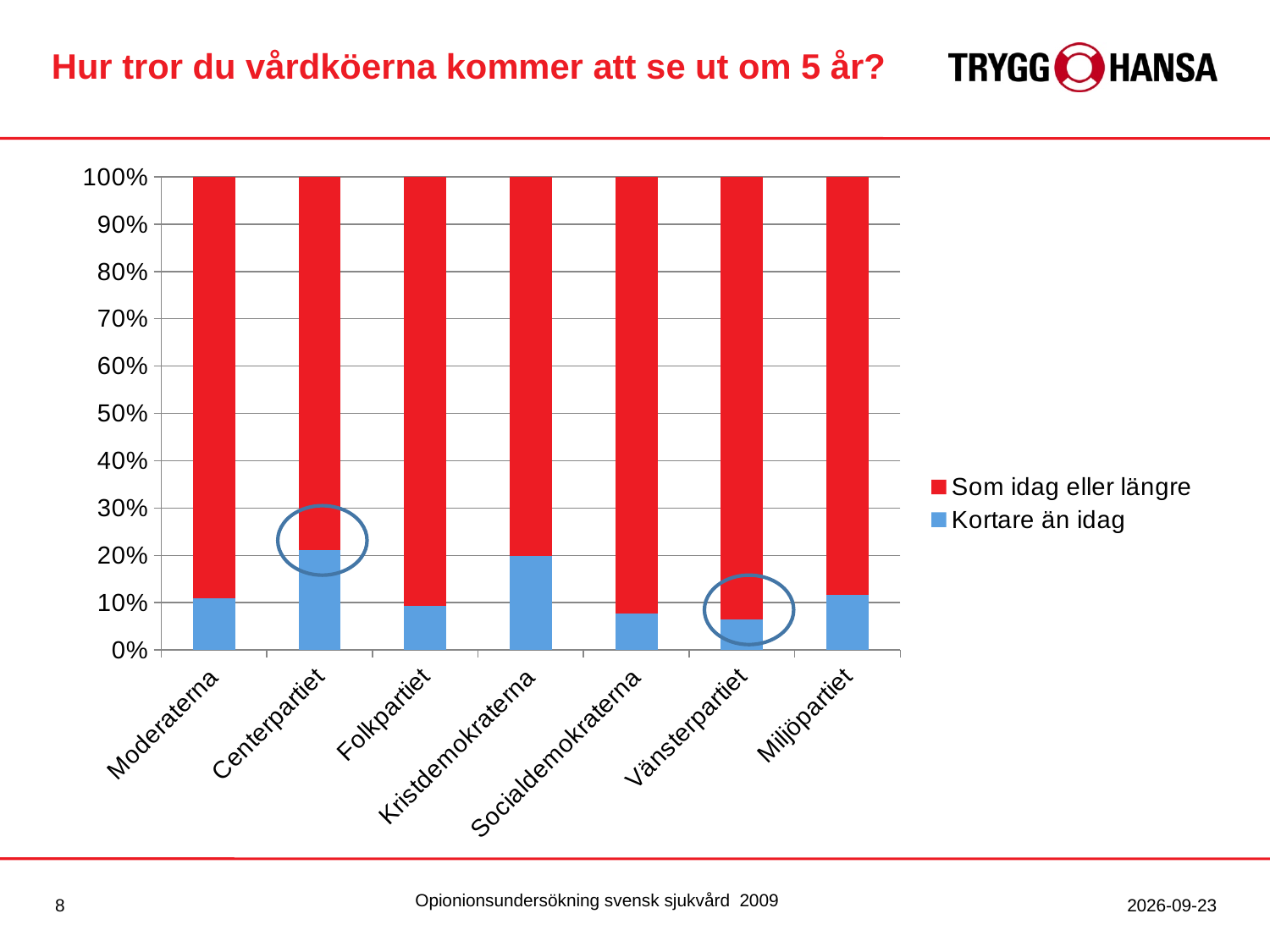
Is the value for 'Kortare än idag' for Kristdemokraterna greater or less than 10%? greater Which series is shown in red in the chart? Som idag eller längre Is the value for 'Kortare än idag' for Vänsterpartiet greater or less than 10%? less What is the title of the slide containing the chart? Hur tror du vårdköerna kommer att se ut om 5 år? Is the value for 'Kortare än idag' for Centerpartiet greater or less than 30%? less How many series does the chart legend list? 2 What kind of chart is shown on the slide? bar chart What is the total height of the stacked bar for Moderaterna? 100% Which has the larger 'Kortare än idag' share, Centerpartiet or Folkpartiet? Centerpartiet How many parties are shown on the x axis of the chart? 7 Which has the larger 'Kortare än idag' share, Kristdemokraterna or Socialdemokraterna? Kristdemokraterna